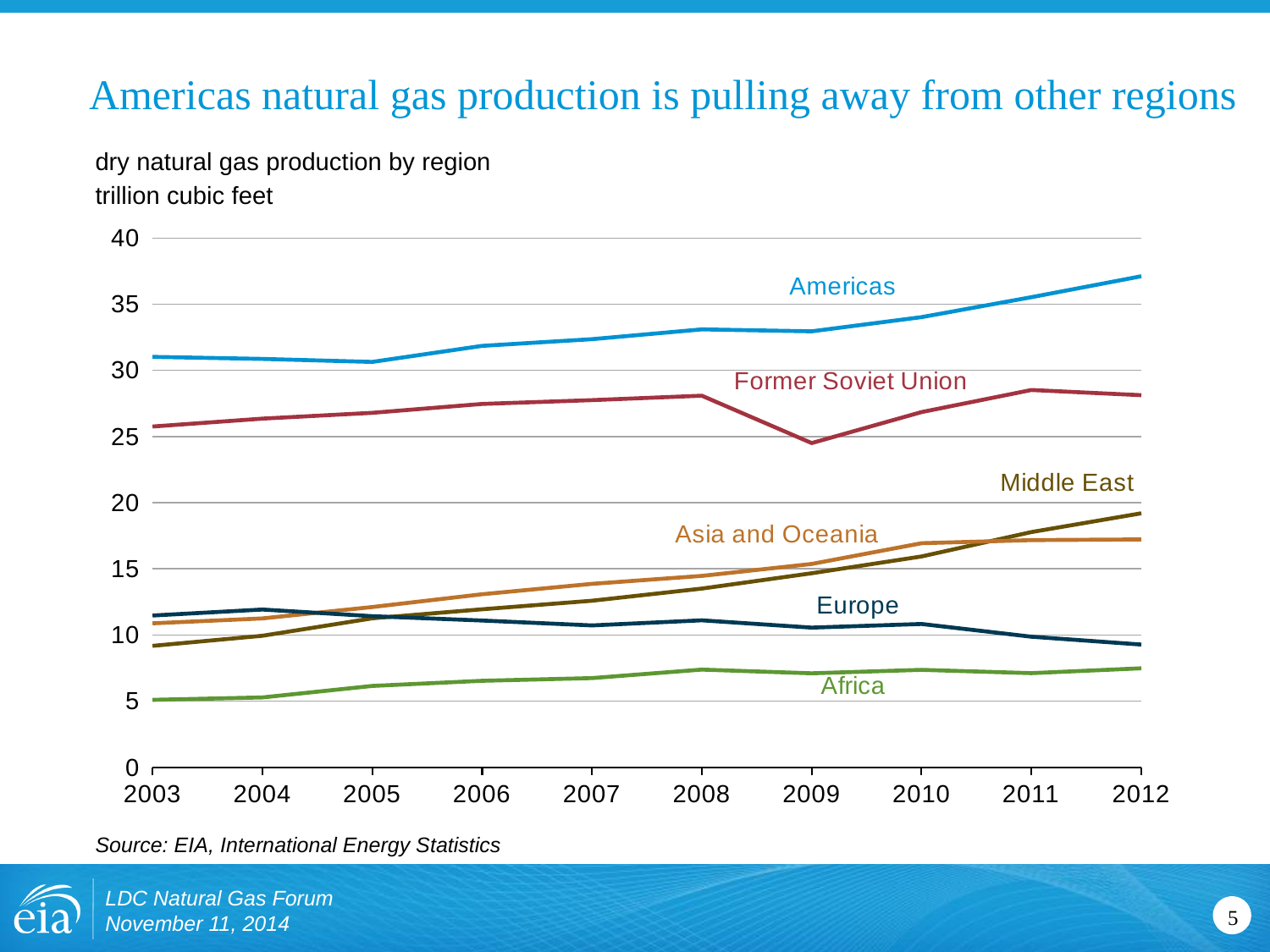
Is the value for Asia and Oceania in 2012 greater or less than 15? greater Is the value for Americas in 2012 greater or less than 35? greater Is the value for Former Soviet Union in 2009 greater or less than 30? less In 2012, which region has the higher production, Middle East or Asia and Oceania? Middle East Which region has the lowest dry natural gas production in 2012? Africa How many years are shown along the x axis of the chart? 10 How many regions are plotted as lines on the chart? 6 Does the Americas line rise or fall from 2003 to 2012? rise What kind of chart is shown on the slide? line chart What unit of measurement is used for the values on the chart? trillion cubic feet Which region has the highest dry natural gas production in 2012? Americas